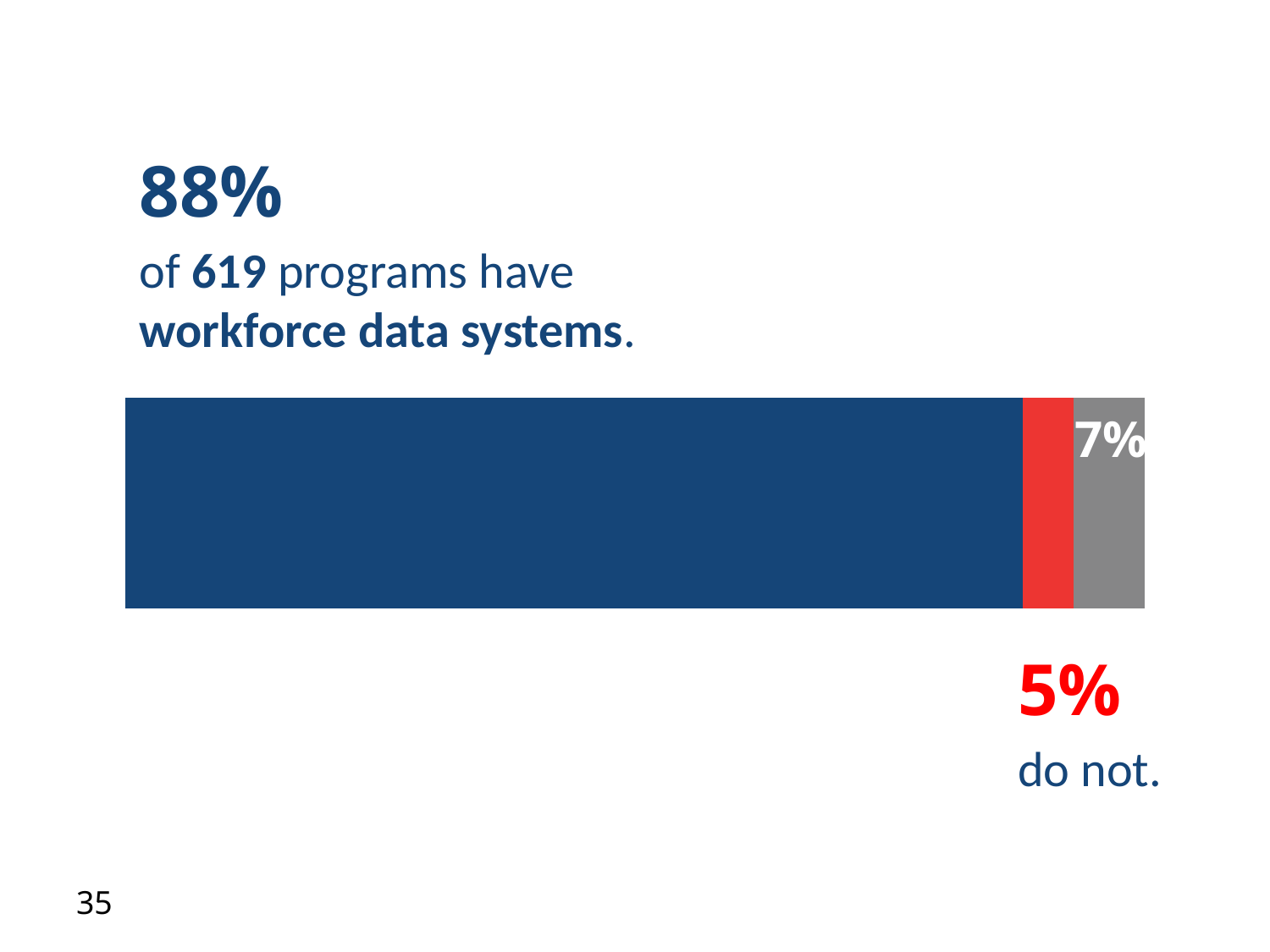
What percentage of the 619 programs have workforce data systems? 88% What value is printed on the gray segment of the bar? 7% What do the three segments of the bar add up to? 100% How many programs does the chart cover in total? 619 Which is larger, the gray segment or the red segment? The gray segment What kind of chart is shown on the slide? A stacked horizontal bar chart Which segment of the bar is the largest? The blue segment (88%, programs with workforce data systems) What is the difference between the gray segment's value and the red segment's value? 2 percentage points What is the difference in percentage points between programs that have workforce data systems and those that do not? 83 percentage points How many segments make up the bar? 3 What percentage of programs do not have workforce data systems? 5% Which segment of the bar is the smallest? The red segment (5%, programs that do not)